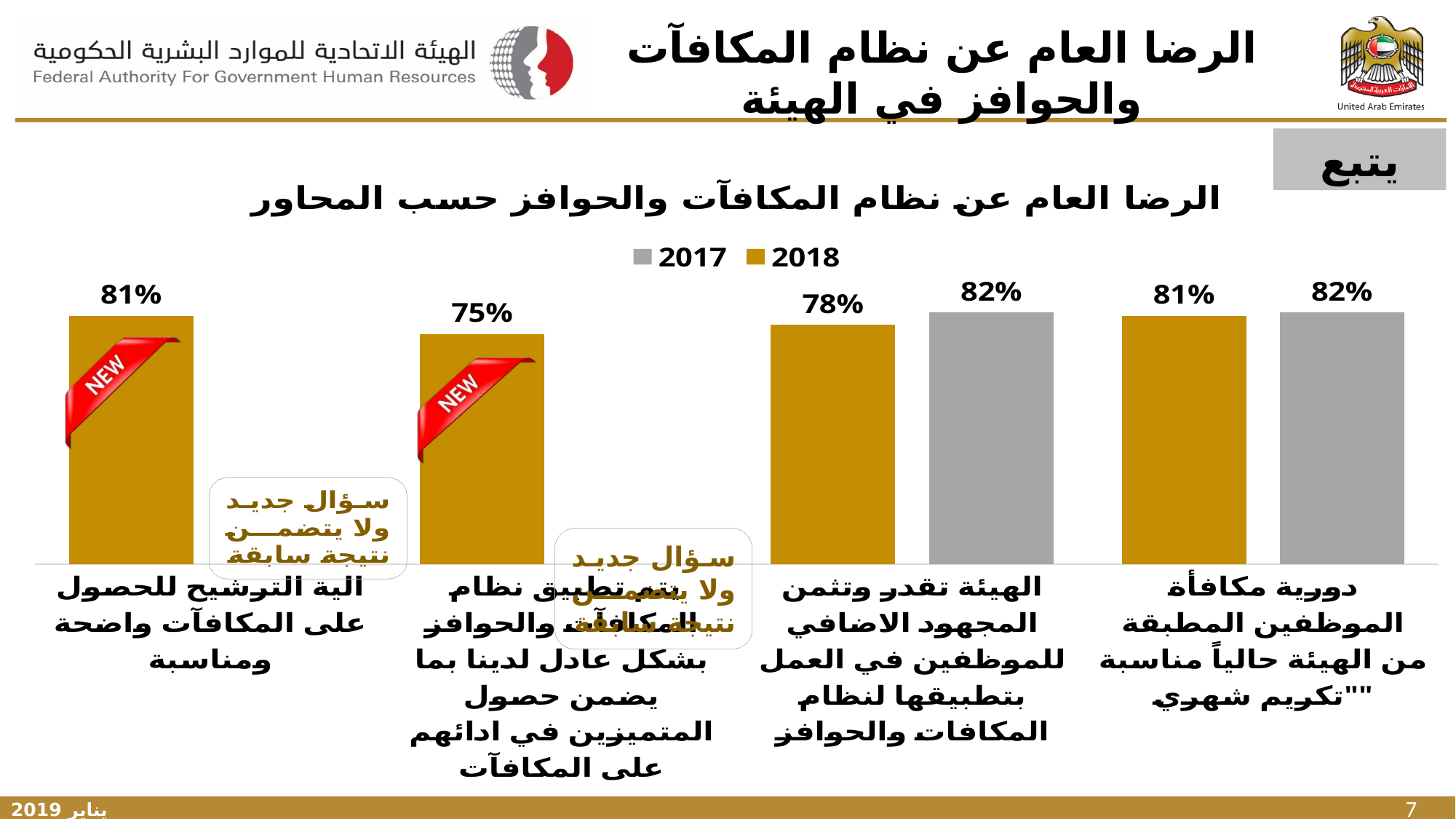
Which years are listed in the chart legend? 2017 and 2018 What is the 2018 value for "دورية مكافأة الموظفين المطبقة من الهيئة حالياً مناسبة "تكريم شهري""? 81% How many series does the chart legend list? 2 What is the difference between the 2017 and 2018 values for "الهيئة تقدر وتثمن المجهود الاضافي للموظفين في العمل بتطبيقها لنظام المكافات والحوافز"? 4% What type of chart is shown on the slide? Bar chart How many categories are shown along the x axis of the chart? 4 What is the 2017 value for "الهيئة تقدر وتثمن المجهود الاضافي للموظفين في العمل بتطبيقها لنظام المكافات والحوافز"? 82% Which category has the lowest 2018 value? يتم تطبيق نظام المكافآت والحوافز بشكل عادل لدينا بما يضمن حصول المتميزين في ادائهم على المكافآت Which colour represents the 2018 series in the chart? Gold What is the 2018 value for "يتم تطبيق نظام المكافآت والحوافز بشكل عادل لدينا بما يضمن حصول المتميزين في ادائهم على المكافآت"? 75% For "دورية مكافأة الموظفين المطبقة من الهيئة حالياً مناسبة "تكريم شهري"", which year has the larger value, 2017 or 2018? 2017 What is the 2018 value for "آلية الترشيح للحصول على المكافآت واضحة ومناسبة"? 81%